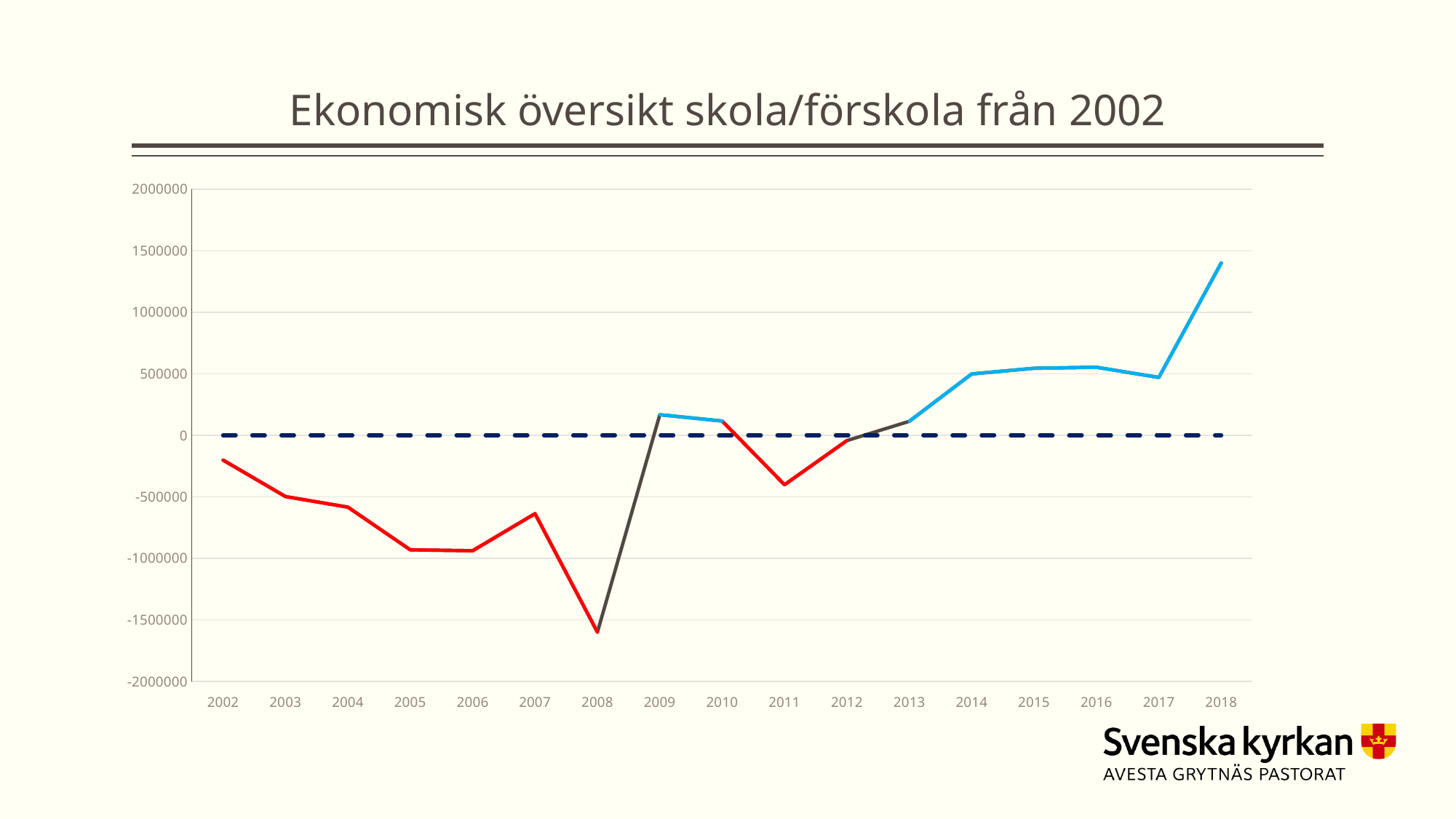
Is the value for 2005 greater or less than -500000? less Which year has the larger value, 2007 or 2008? 2007 Is the value for 2008 greater or less than -1500000? less How many years are shown on the x axis of the chart? 17 Do the values generally rise or fall from 2012 to 2018? rise Is the value for 2018 greater or less than 1000000? greater What kind of chart is shown on the slide? line chart Which year has the lowest value on the chart? 2008 Which year has the highest value on the chart? 2018 Which year has the larger value, 2011 or 2016? 2016 What is the title of the chart? Ekonomisk översikt skola/förskola från 2002